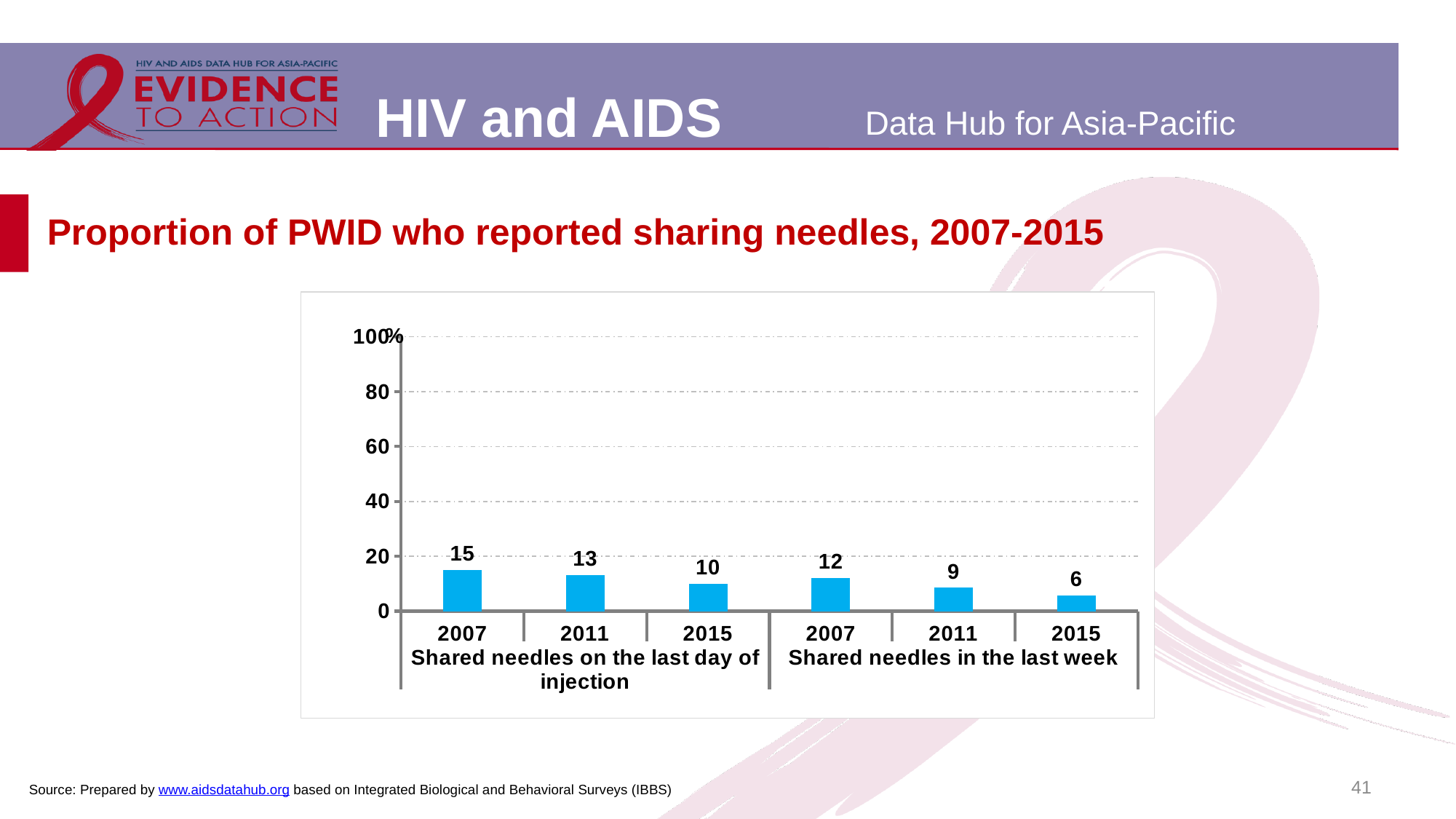
What kind of chart is shown on the slide? Bar chart What is the value for 2015 under 'Shared needles in the last week'? 6 What is the difference between the 2007 and 2015 values under 'Shared needles on the last day of injection'? 5 What is the value for 2007 under 'Shared needles on the last day of injection'? 15 Which bar has the lowest value on the chart? 2015, Shared needles in the last week Which bar has the highest value on the chart? 2007, Shared needles on the last day of injection How many bars are plotted on the chart? 6 What is the difference between the 2007 and 2015 values under 'Shared needles in the last week'? 6 Do the values rise or fall from 2007 to 2015 within each group? Fall Which is larger: the 2011 value for 'Shared needles on the last day of injection' or the 2011 value for 'Shared needles in the last week'? Shared needles on the last day of injection What is the value for 2011 under 'Shared needles in the last week'? 9 Is the value for 2007 under 'Shared needles in the last week' greater or less than 20? less